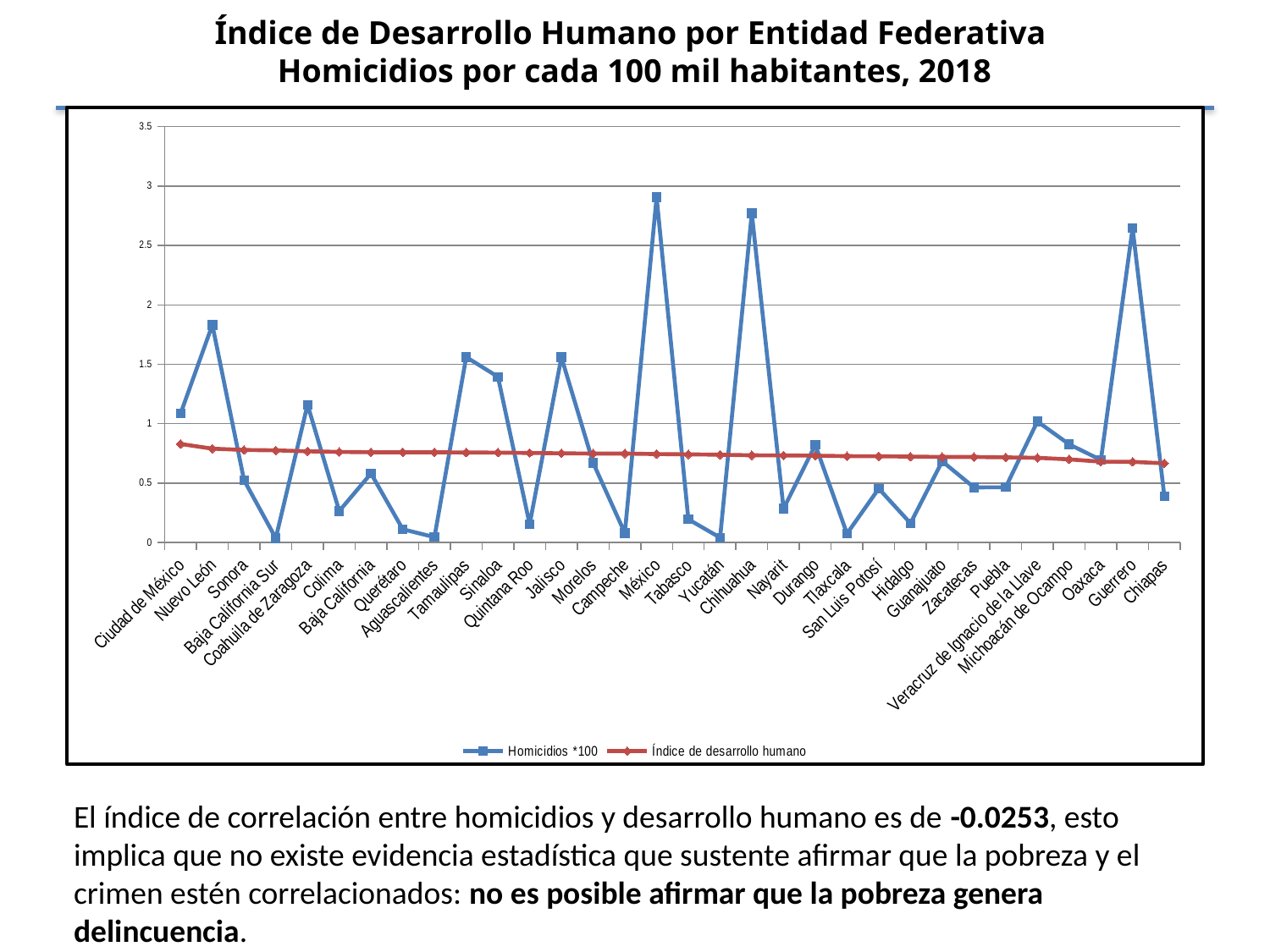
Which has the larger Homicidios *100 value, Nuevo León or Sonora? Nuevo León Is the Homicidios *100 value for Chiapas greater or less than 0.5? less Is the Homicidios *100 value for México greater or less than 2.5? greater How many series does the legend list? 2 How many entidades federativas (categories) are plotted along the x axis? 32 Which colour is used for the Índice de desarrollo humano series? Red Which entidad federativa has the highest value for Homicidios *100? México Is the Homicidios *100 value for Nuevo León greater or less than 1.5? greater What kind of chart is shown on the slide? Line chart Does the Índice de desarrollo humano line rise or fall from Ciudad de México to Chiapas? Fall